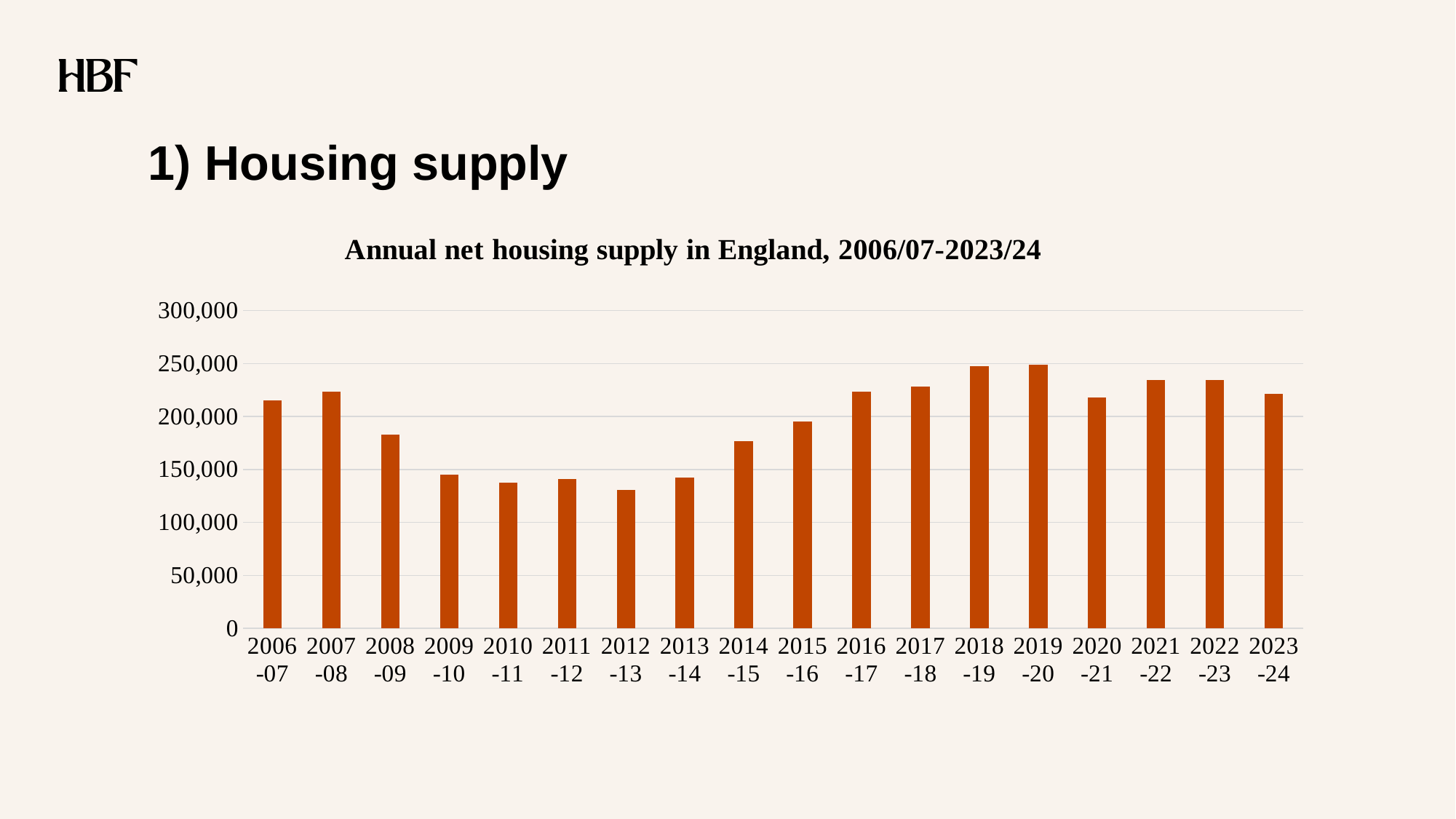
Is the value for 2008-09 greater or less than 150,000? greater Do the values rise or fall from 2012-13 to 2018-19? rise How many years (bars) are plotted in the chart? 18 Do the values rise or fall from 2007-08 to 2012-13? fall Which year has the lowest annual net housing supply? 2012-13 Is the value for 2018-19 greater or less than 200,000? greater Is the value for 2012-13 greater or less than 150,000? less What kind of chart is shown on the slide? bar chart What is the title of the chart? Annual net housing supply in England, 2006/07-2023/24 Which is larger, the value for 2007-08 or the value for 2009-10? 2007-08